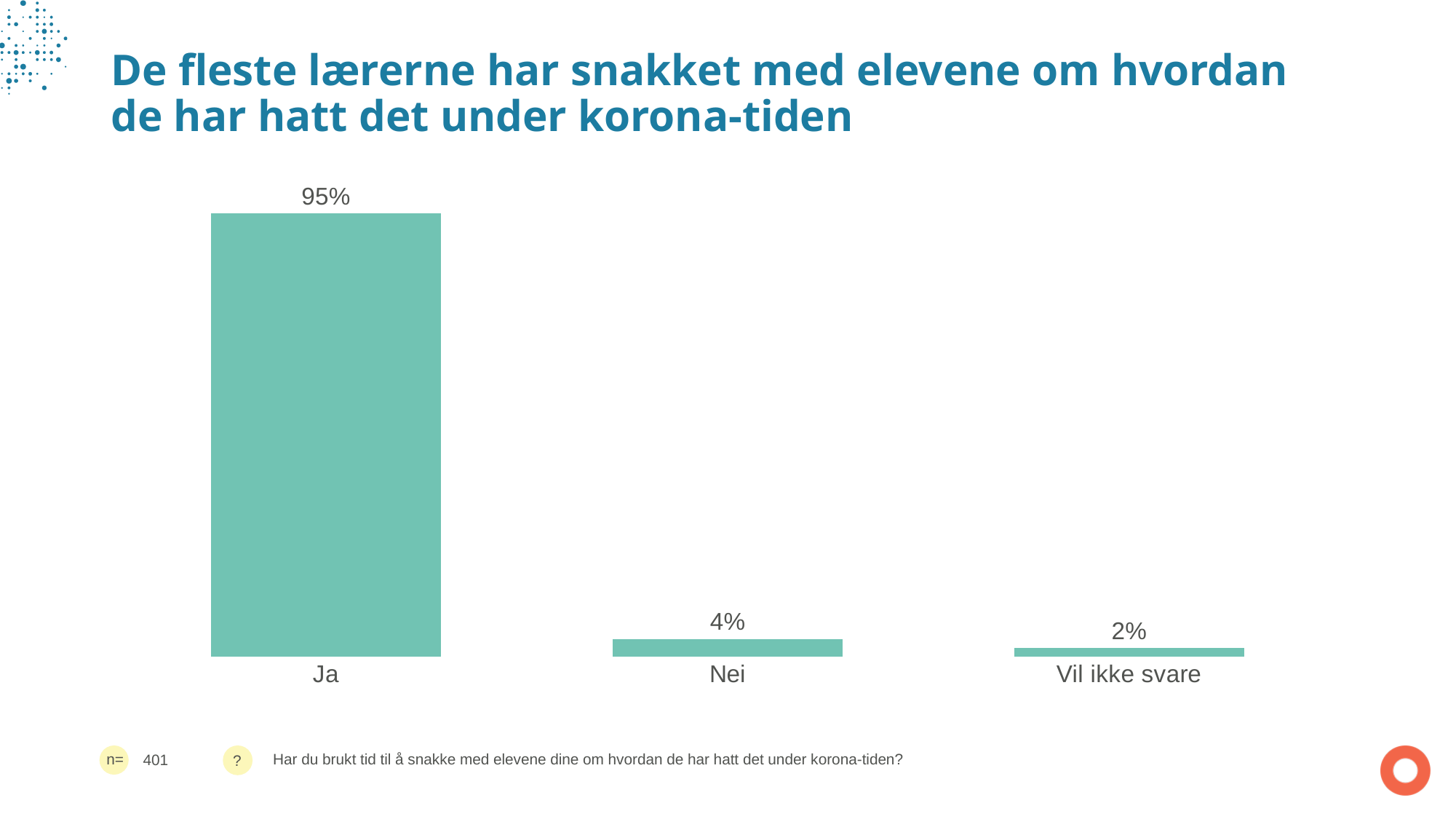
What kind of chart is shown on the slide? Bar chart What is the difference between the values for Nei and Vil ikke svare? 2% What is the difference between the values for Ja and Nei? 91% Which category has the lowest value? Vil ikke svare What is the value for Vil ikke svare? 2% How many categories are shown in the chart? 3 What is the value for Nei? 4% What is the value for Ja? 95% Which category has the highest value? Ja Which is larger, the value for Nei or the value for Vil ikke svare? Nei What is the sample size (n) shown on the slide? 401 Do the values rise or fall from left to right across the categories? Fall